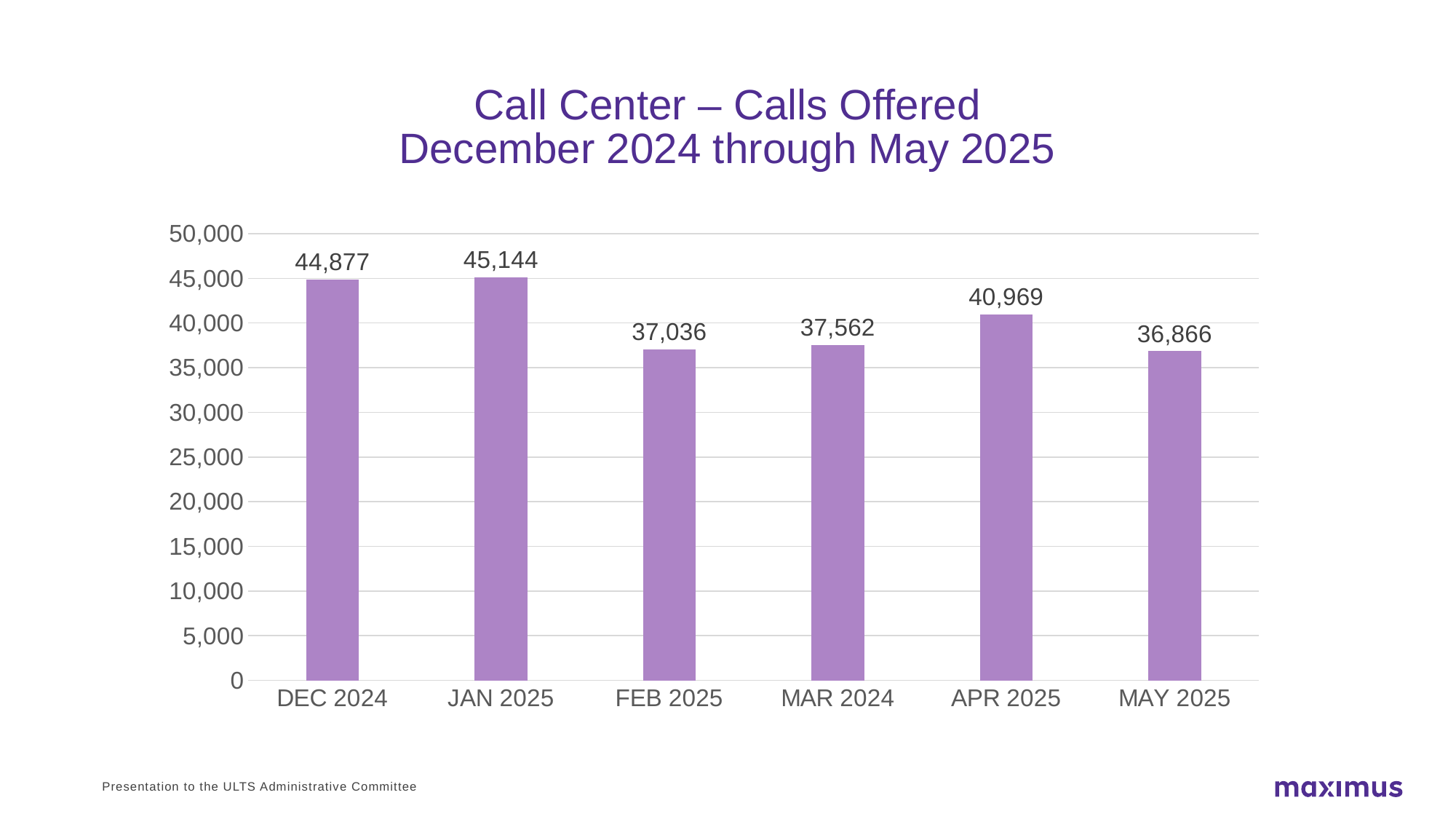
What is the difference between the values for JAN 2025 and DEC 2024? 267 Is the value for APR 2025 greater or less than 40,000? greater How many months are shown on the x axis? 6 What is the title of the chart? Call Center – Calls Offered December 2024 through May 2025 What is the value for APR 2025? 40,969 Which month has the lowest number of calls offered? MAY 2025 Which month has the highest number of calls offered? JAN 2025 What is the difference between the values for APR 2025 and MAY 2025? 4,103 How many calls were offered in DEC 2024? 44,877 What is the value for MAY 2025? 36,866 Which is larger, the value for FEB 2025 or the value for MAR 2024? MAR 2024 What kind of chart is shown on the slide? bar chart